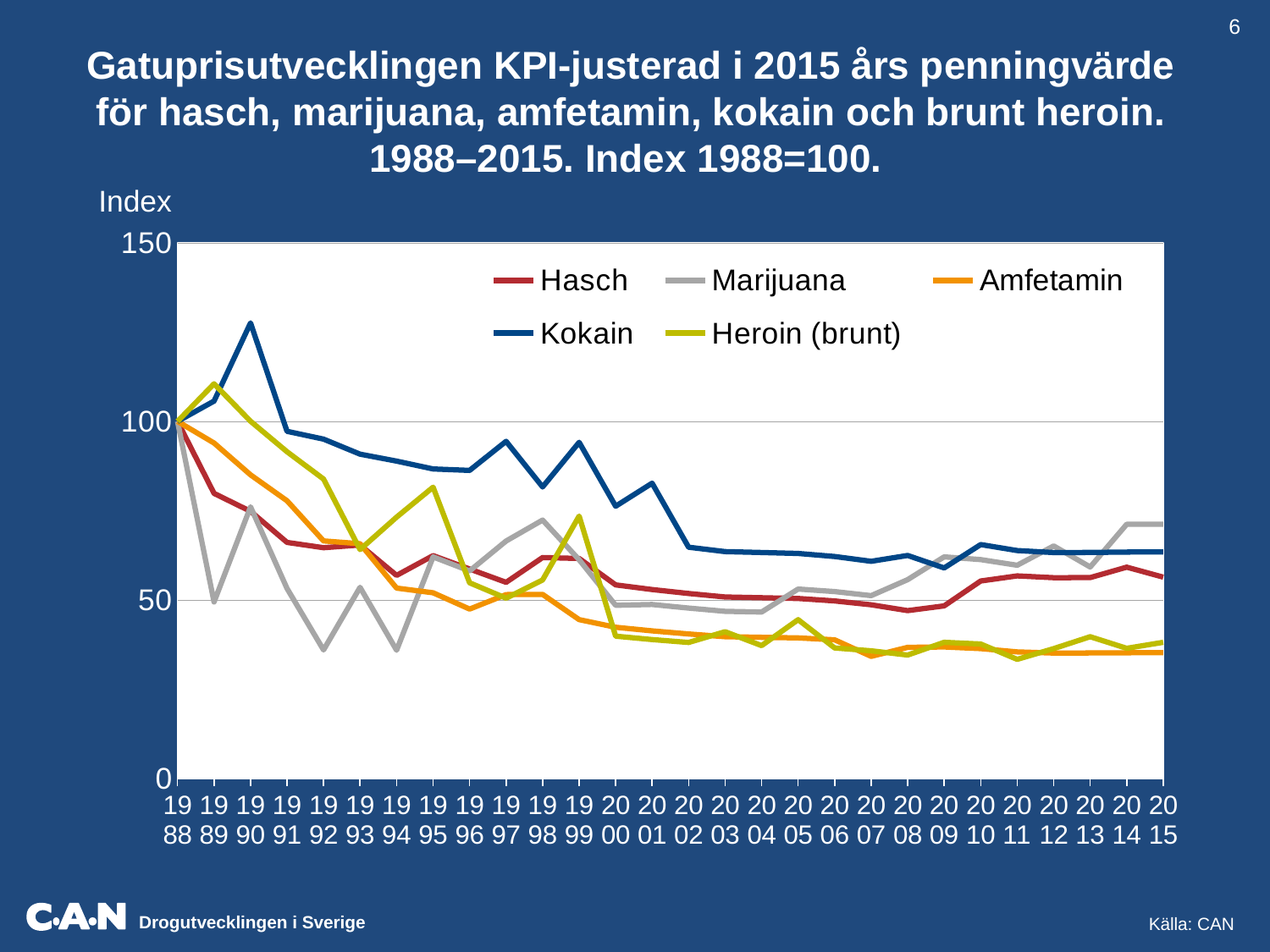
What is the index value for Kokain in 1988? 100 In 2002, which is higher, Kokain or Hasch? Kokain What colour is the Kokain line in the legend? blue Is the value for Kokain in 1990 greater or less than 100? greater How many series does the legend list? 5 Does the Kokain series overall rise or fall from 1988 to 2015? fall Which series has the lowest value in 1992? Marijuana Is the value for Marijuana in 1992 greater or less than 50? less Is the value for Amfetamin in 2015 greater or less than 50? less How many years are plotted along the x axis? 28 What kind of chart is shown on the slide? line chart Which series has the highest value in 1990? Kokain